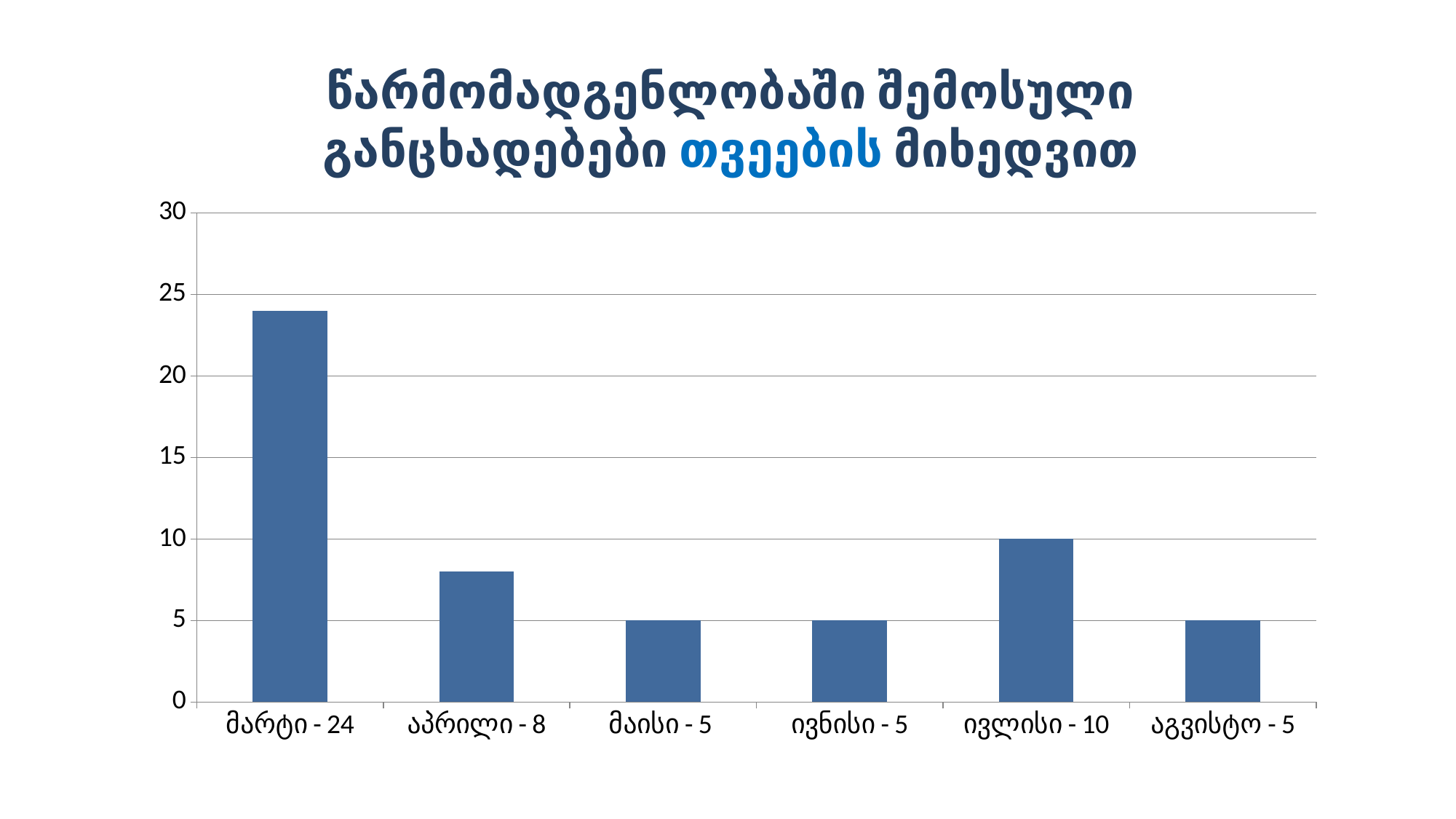
How many months are shown on the chart? 6 Which is larger, the value for აპრილი or the value for ივლისი? ივლისი What is the value for აპრილი (April)? 8 Is the value for მარტი greater or less than 20? greater What is the highest value shown on the vertical axis? 30 What kind of chart is shown on the slide? bar chart What is the difference between the values for მარტი and აპრილი? 16 What is the value for მარტი (March)? 24 What is the value for ივლისი (July)? 10 What is the difference between the values for ივლისი and ივნისი? 5 Which month has the highest value? მარტი What is the total of the values for მაისი, ივნისი and აგვისტო? 15